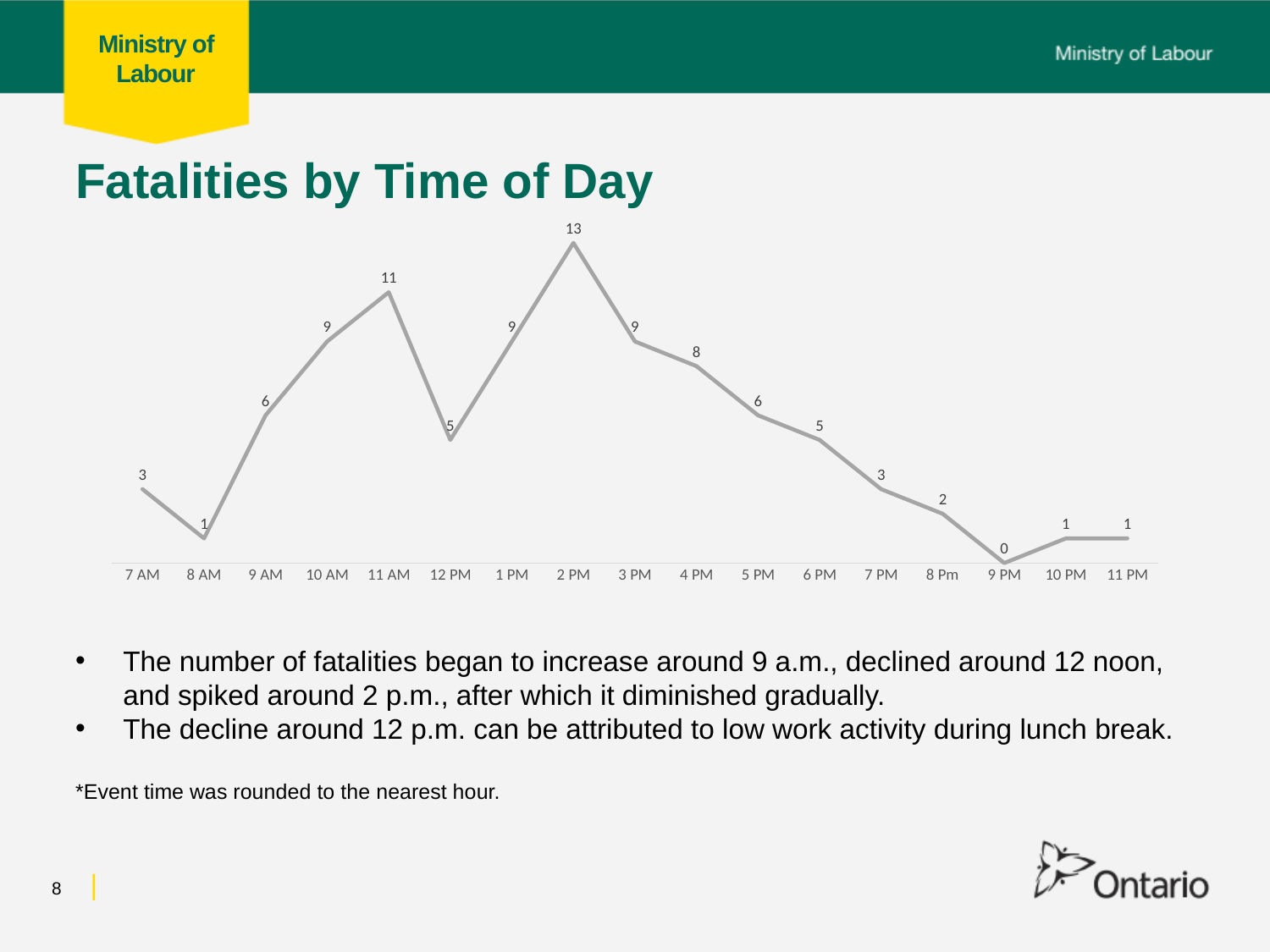
What is the number of fatalities at 2 PM? 13 What is the number of fatalities at 8 AM? 1 What kind of chart is shown on the slide? Line chart What is the number of fatalities at 12 PM? 5 What is the title of the chart? Fatalities by Time of Day At which time of day is the number of fatalities lowest? 9 PM At which time of day is the number of fatalities highest? 2 PM What is the difference between the fatalities at 11 AM and at 12 PM? 6 What is the difference between the fatalities at 2 PM and at 7 AM? 10 Do the fatalities rise or fall from 2 PM to 9 PM? Fall Which has more fatalities, 10 AM or 4 PM? 10 AM How many time-of-day points are plotted on the chart? 17